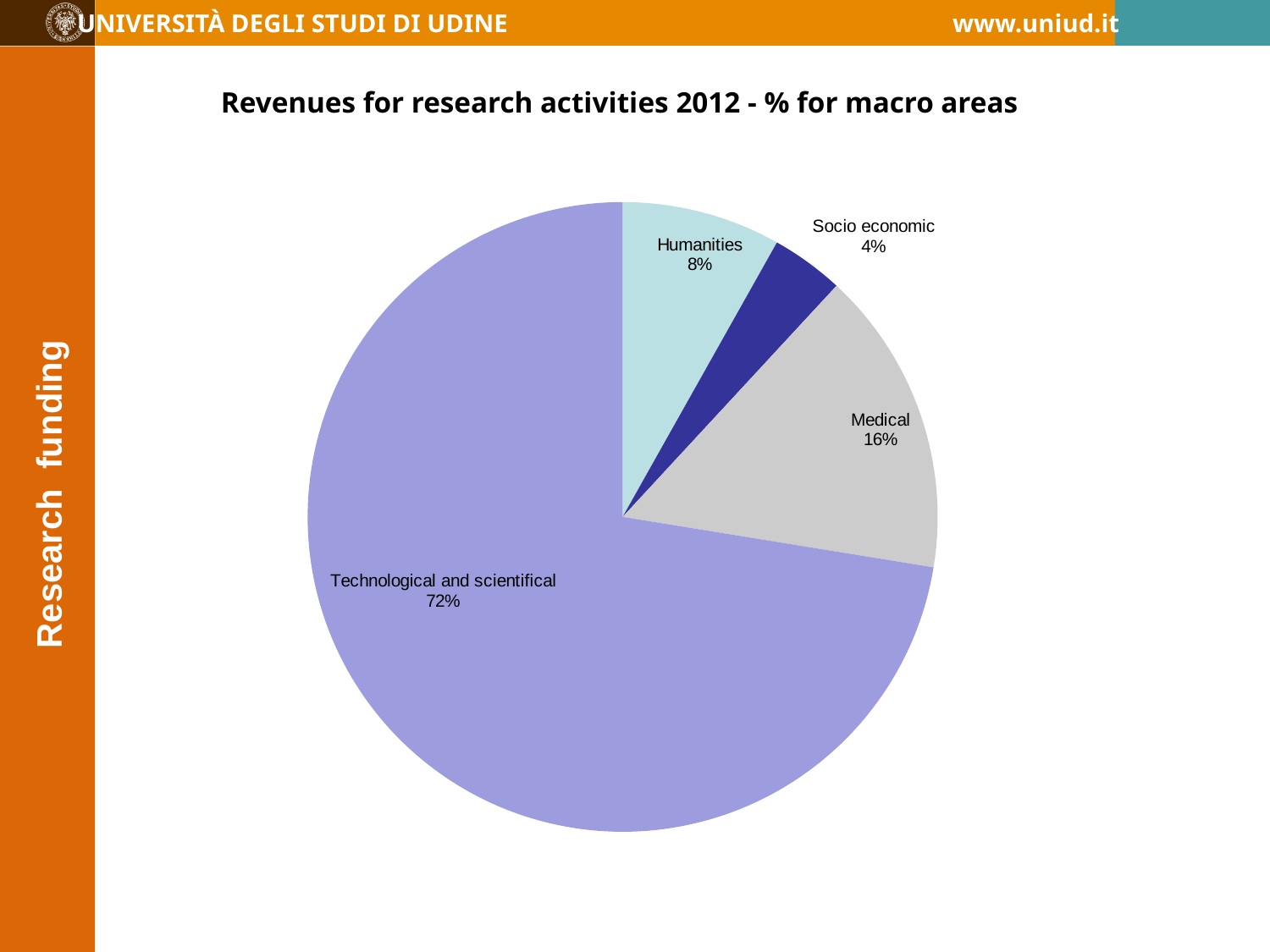
What is the difference in percentage points between Medical and Humanities? 8 What share of the pie does Medical account for? 16% What is the value shown for Humanities? 8% Which is larger, the share for Humanities or the share for Socio economic? Humanities What is the title of the chart? Revenues for research activities 2012 - % for macro areas What percentage is shown for Socio economic? 4% How many macro areas are shown in the pie chart? 4 Which macro area has the largest share of revenues? Technological and scientifical What is the difference in percentage points between Technological and scientific and Medical? 56 What percentage of revenues for research activities 2012 comes from the Technological and scientific macro area? 72% What kind of chart is shown on the slide? Pie chart Which macro area has the smallest share of revenues? Socio economic